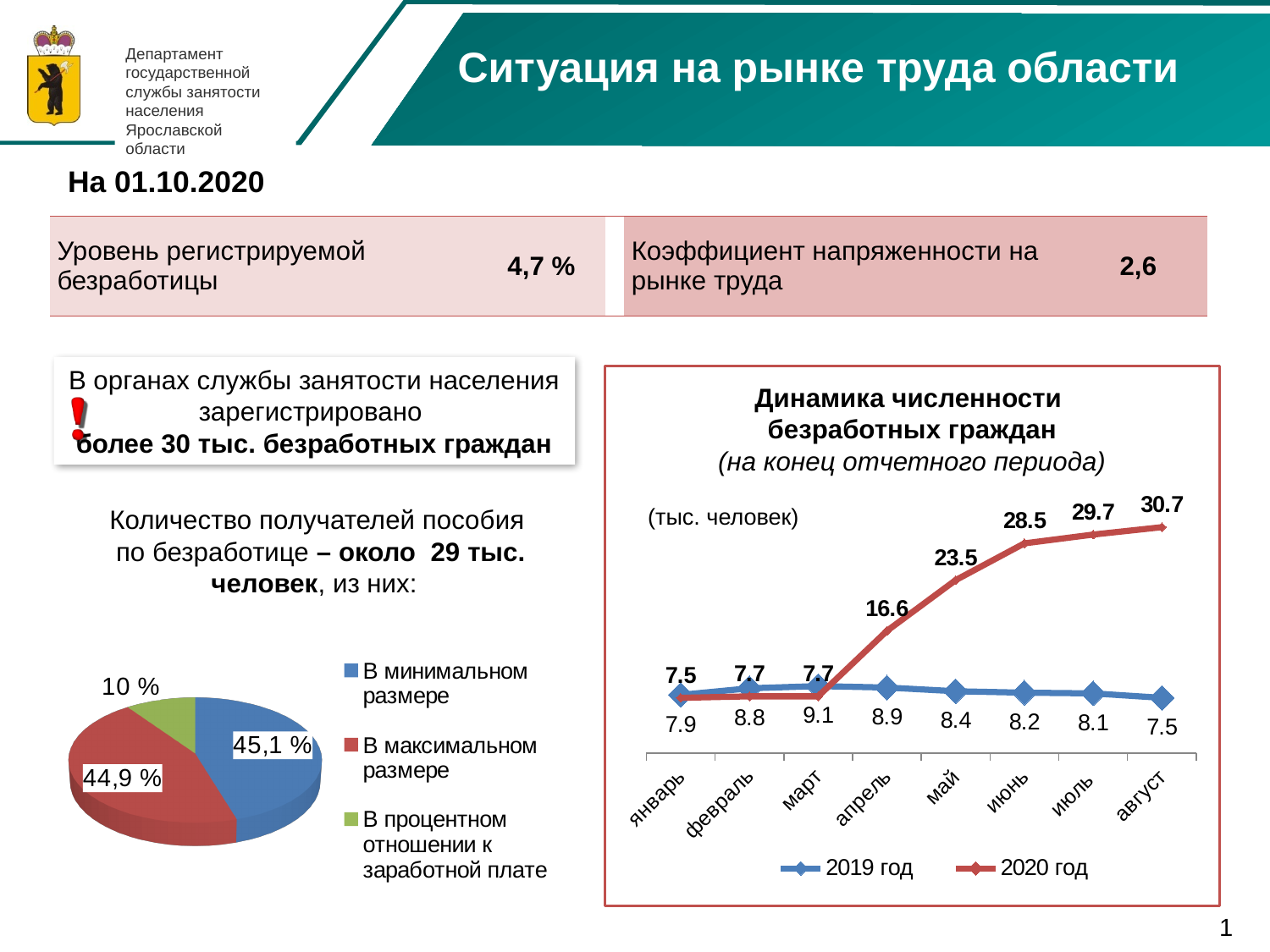
On the line chart 'Динамика численности безработных граждан', what is the value for 2019 год in март? 9.1 On the line chart 'Динамика численности безработных граждан', which series has the larger value in январь, 2019 год or 2020 год? 2019 год On the line chart 'Динамика численности безработных граждан', in which month is the 2019 год series lowest? август What kind of chart is the chart on the bottom left of the slide? pie chart On the line chart 'Динамика численности безработных граждан', does the 2020 год series rise or fall from март to август? rise On the line chart 'Динамика численности безработных граждан', how many months are shown on the x axis? 8 On the line chart 'Динамика численности безработных граждан', in which month is the 2020 год series highest? август On the line chart 'Динамика численности безработных граждан', what is the value for 2020 год in август? 30.7 On the pie chart on the bottom left, what is the value of the slice 'В минимальном размере'? 45,1 % On the pie chart on the bottom left, what share is labelled 'В процентном отношении к заработной плате'? 10 % On the line chart 'Динамика численности безработных граждан', what is the difference between the 2020 год and 2019 год values in июнь? 20.3 On the line chart 'Динамика численности безработных граждан', how many series does the legend list? 2